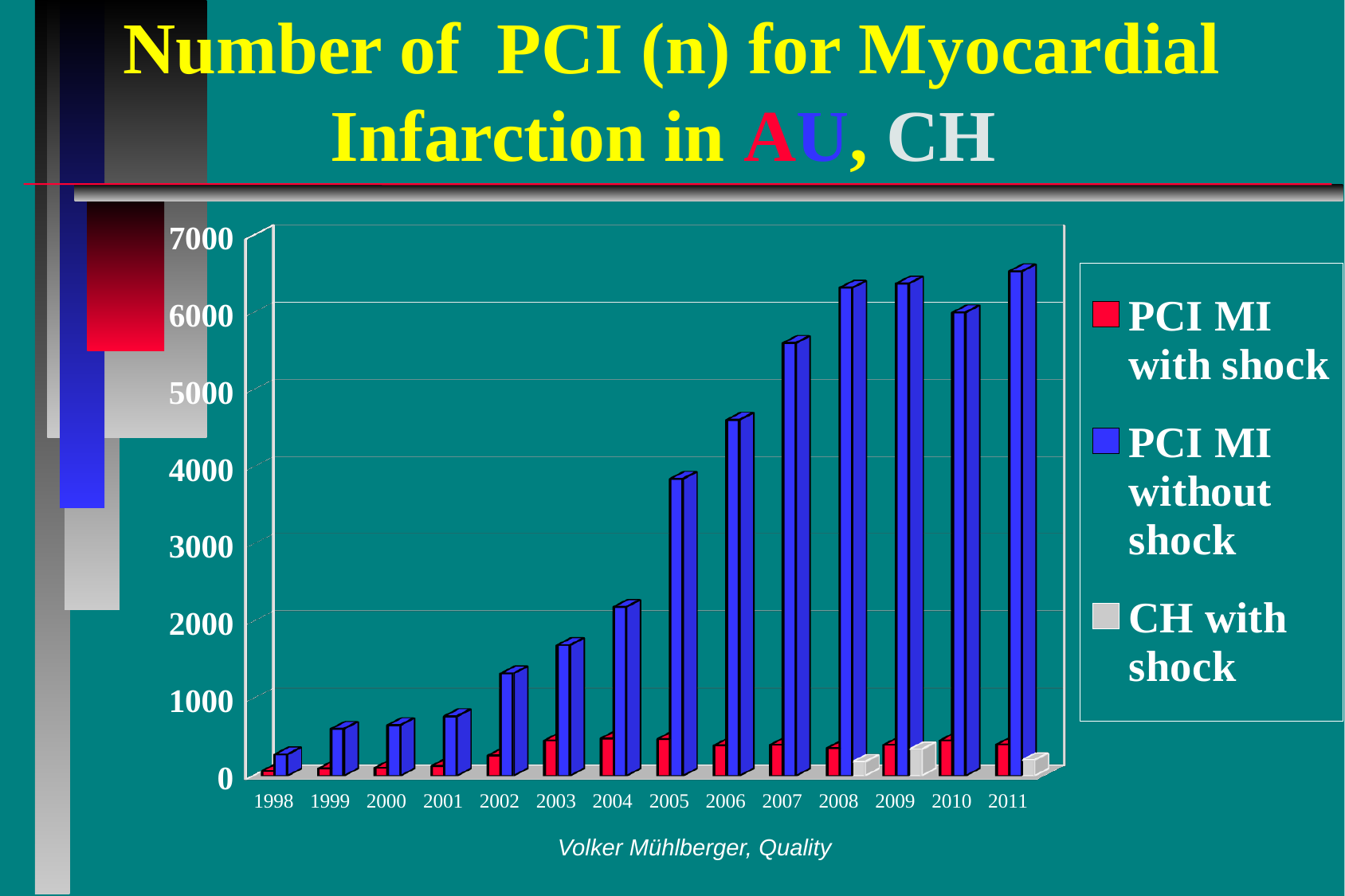
Which is larger for PCI MI without shock, 2008 or 2010? 2008 What kind of chart is shown on the slide? bar chart Which year has the lowest value for PCI MI without shock? 1998 Is the value for PCI MI with shock in 2011 greater or less than 1000? less Is the value for PCI MI without shock in 2005 greater or less than 3000? greater Which year has the highest value for PCI MI without shock? 2011 Which colour represents PCI MI with shock in the legend? red Do the values for PCI MI without shock generally rise or fall from 1998 to 2011? rise Is the value for PCI MI without shock in 2007 greater or less than 5000? greater How many series does the legend list? 3 How many years are shown on the x axis? 14